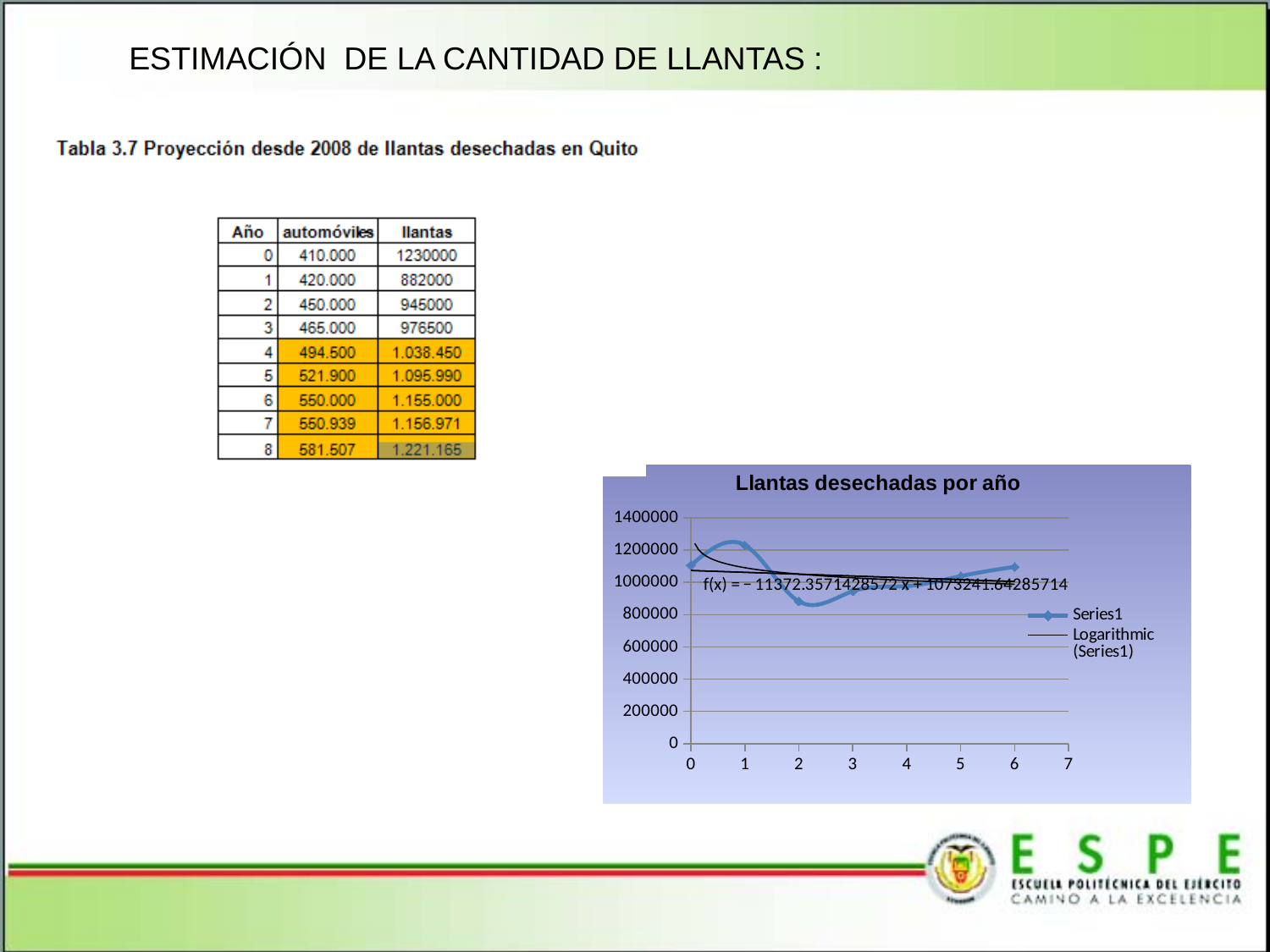
Is the Series1 value at x = 6 greater or less than 1000000? greater Does the logarithmic trendline rise or fall as x increases? fall Is the Series1 value at x = 0 greater or less than 1000000? greater Is the Series1 value at x = 2 greater or less than 1000000? less Does Series1 rise or fall between x = 2 and x = 6? rise What type of chart is 'Llantas desechadas por año'? line chart What are the two entries in the chart's legend? Series1 and Logarithmic (Series1) How many data points are plotted for Series1 in the chart? 7 What is the title of the chart on the slide? Llantas desechadas por año How many entries does the legend of the chart list? 2 At which x value does Series1 reach its lowest point? 2